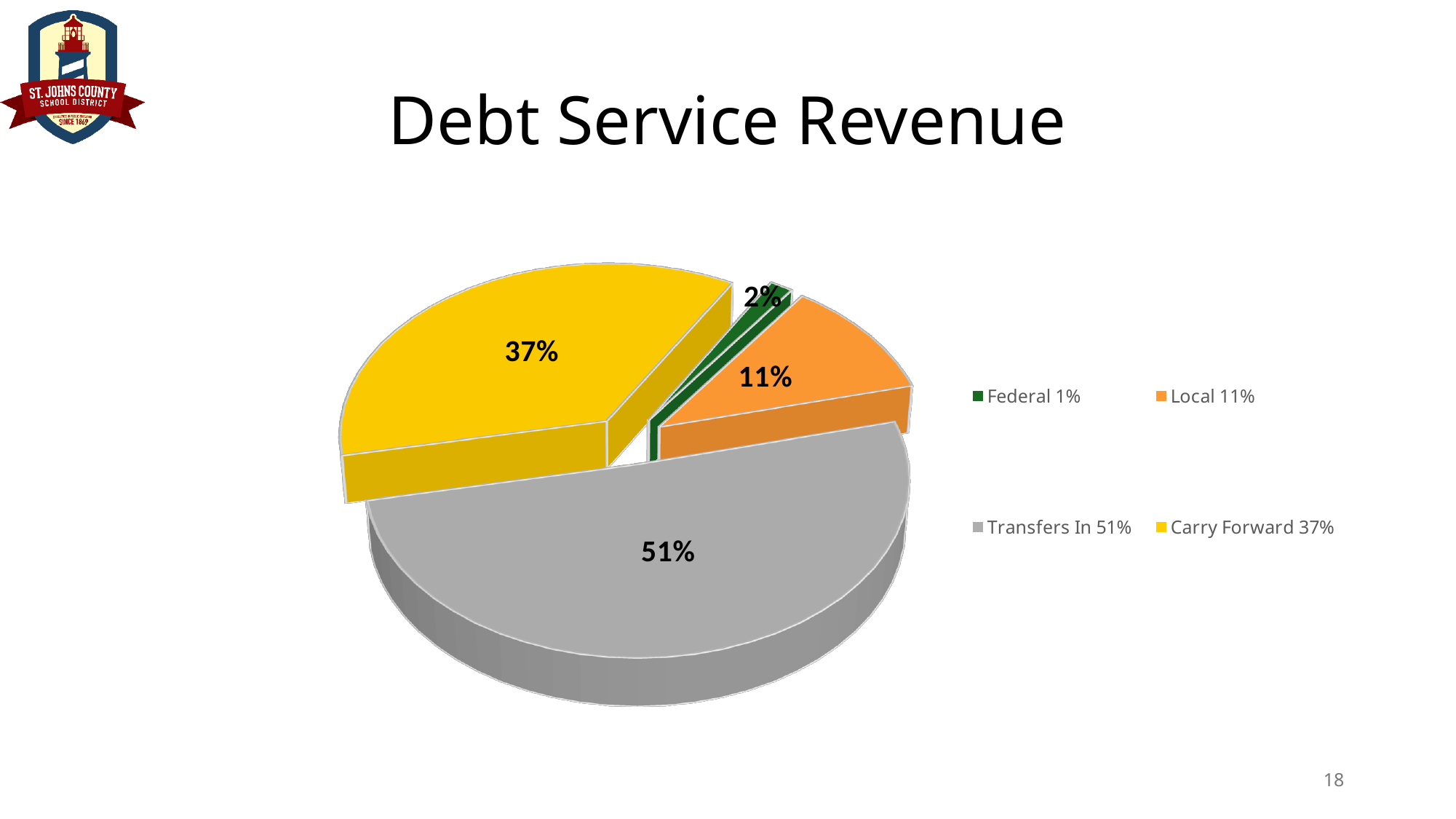
What is the difference in percentage points between the Carry Forward share and the Local share? 26 Which category has the smallest share of Debt Service Revenue? Federal Which category has the largest share of Debt Service Revenue? Transfers In What is the difference in percentage points between the Transfers In share and the Carry Forward share? 14 What share of Debt Service Revenue is Transfers In? 51% What share of Debt Service Revenue is Carry Forward? 37% What kind of chart is shown on the slide? pie chart What is the title of the chart? Debt Service Revenue What share of Debt Service Revenue is Local? 11% What colour is the Transfers In slice? gray Which is larger, the Carry Forward share or the Local share? Carry Forward How many categories does the legend list? 4